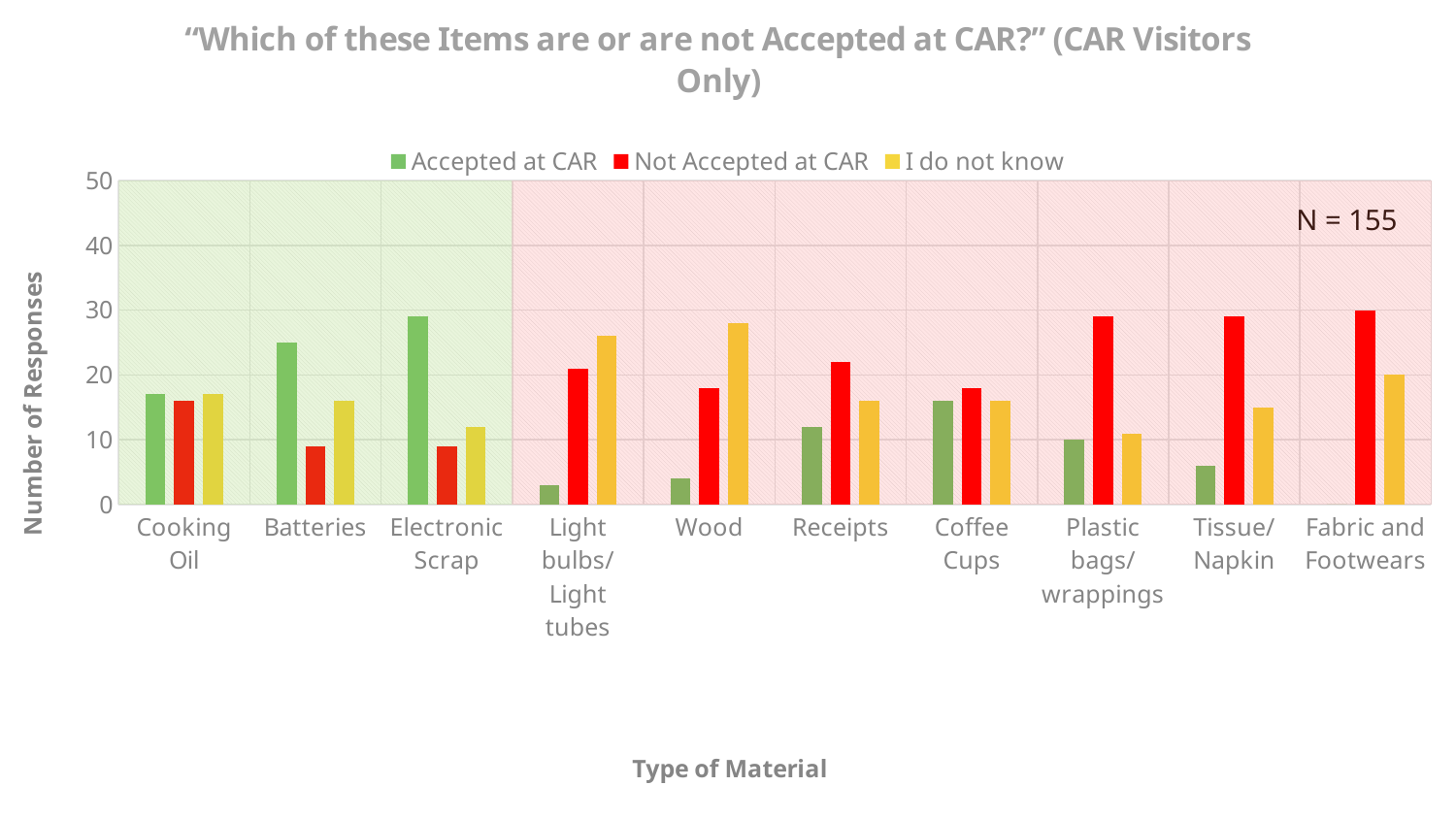
Is the 'Not Accepted at CAR' value for Plastic bags/wrappings greater or less than 20? greater For Batteries, which is larger: 'Accepted at CAR' or 'Not Accepted at CAR'? Accepted at CAR Is the 'Accepted at CAR' value for Tissue/Napkin greater or less than 10? less For Wood, which is larger: 'Not Accepted at CAR' or 'I do not know'? I do not know Is the 'I do not know' value for Wood greater or less than 20? greater What sample size (N) is shown on the chart? N = 155 How many material categories are shown on the x axis? 10 Which material has the highest 'Accepted at CAR' value? Electronic Scrap How many series does the legend list? 3 What kind of chart is shown on the slide? Bar chart